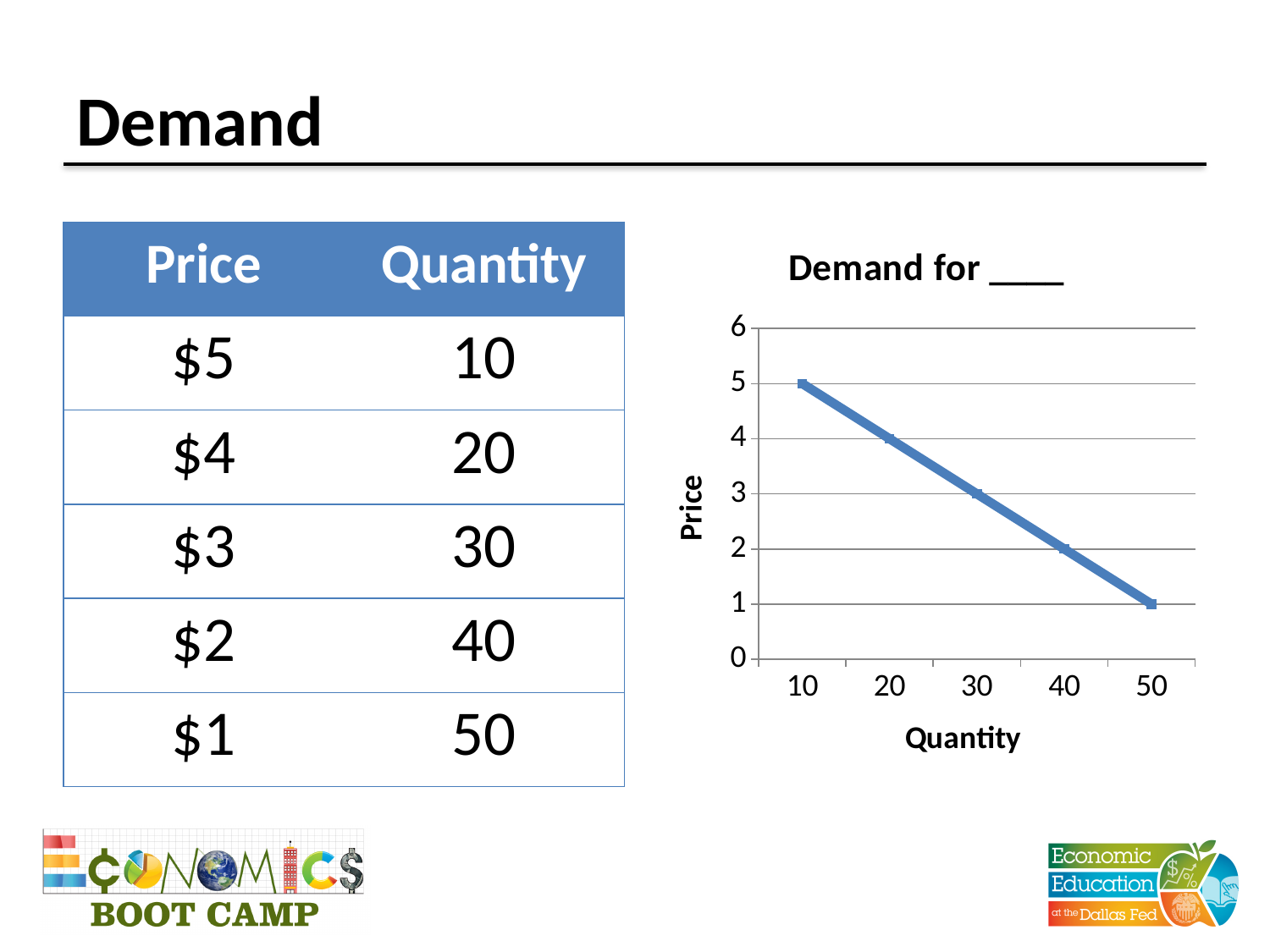
What is the difference between the price at quantity 20 and the price at quantity 40? 2 Which is larger: the price at quantity 20 or the price at quantity 40? the price at quantity 20 At which quantity is the price highest in the chart? 10 What kind of chart is shown on the slide? line chart Does the price rise or fall as quantity increases along the x axis? fall In the chart, what is the price when the quantity is 50? 1 What is the title of the chart? Demand for ____ How many data points are plotted on the demand line? 5 In the chart, what is the price when the quantity is 30? 3 What is the label of the vertical axis of the chart? Price In the chart, what is the price when the quantity is 10? 5 At which quantity is the price lowest in the chart? 50